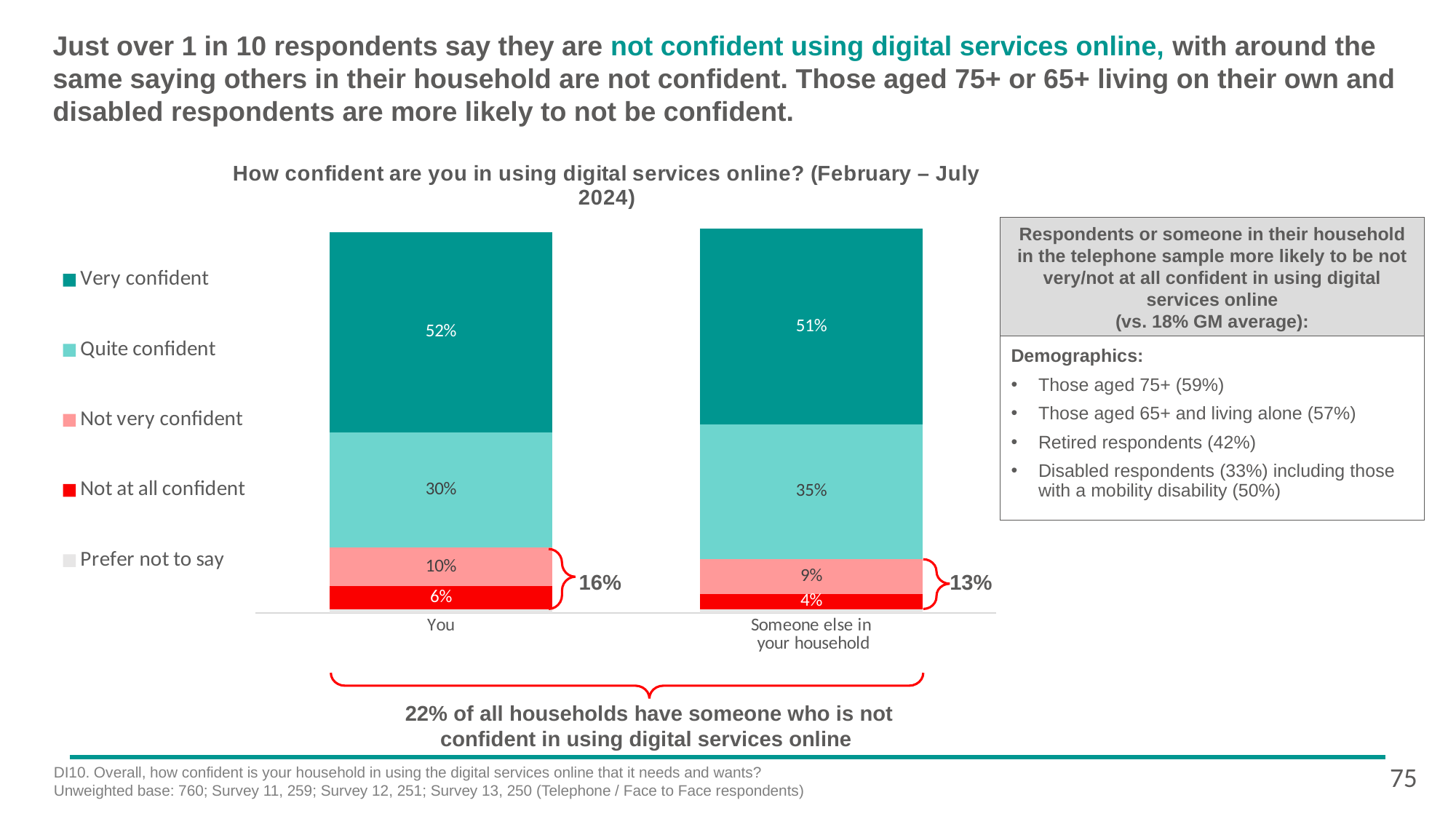
What kind of chart is shown on the slide? Stacked bar chart How many series does the legend list? 5 What is the difference between the 'Quite confident' values for 'Someone else in your household' and 'You'? 5% What combined percentage is shown by the bracket for the not confident segments of the 'You' bar? 16% What is the 'Not at all confident' value for the 'You' bar? 6% How many bars (categories) are shown on the x axis? 2 What is the 'Not very confident' value for 'Someone else in your household'? 9% What combined percentage is shown by the bracket for the not confident segments of the 'Someone else in your household' bar? 13% Which segment is the largest in the 'You' bar? Very confident Which bar has the higher 'Not at all confident' value, 'You' or 'Someone else in your household'? You What percentage of respondents say they are 'Very confident' for the 'You' bar? 52% What is the 'Quite confident' value for 'Someone else in your household'? 35%